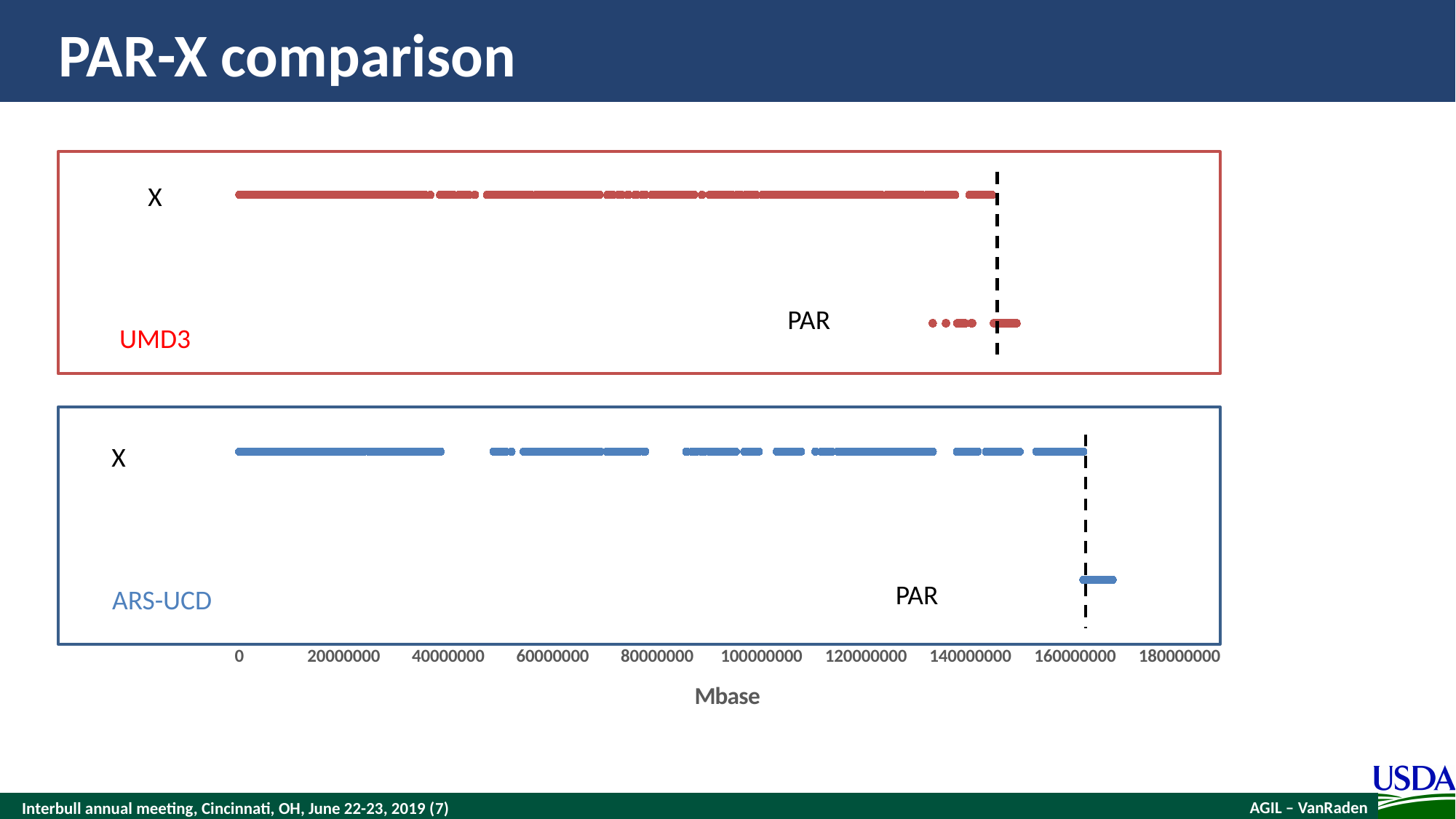
What colour are the points in the UMD3 chart? red What kind of chart is used in the UMD3 and ARS-UCD panels? scatter chart In the UMD3 chart, at what Mbase value does the X region begin? 0 In the UMD3 chart, is the end of the PAR region greater or less than 160000000? less In the UMD3 chart, is the end of the X region greater or less than 160000000? less Which assembly's PAR region starts at a larger Mbase position, UMD3 or ARS-UCD? ARS-UCD How many assemblies (panels) are compared on the slide? 2 What is the label of the horizontal axis shared by the two charts? Mbase Which assembly's X region extends further along the Mbase axis, UMD3 or ARS-UCD? ARS-UCD In the UMD3 chart, is the start of the PAR region greater or less than 120000000? greater